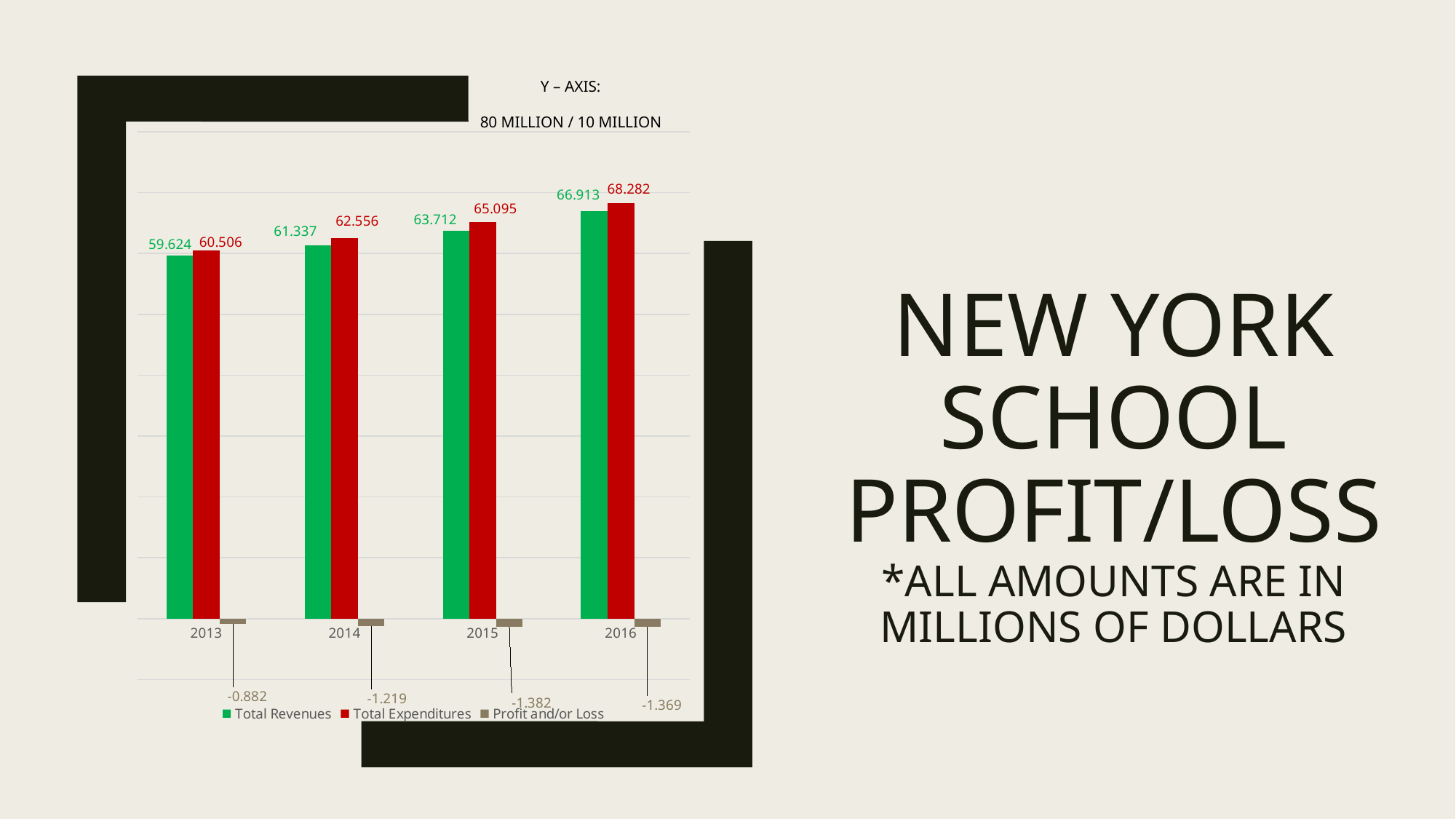
What kind of chart is shown on the slide? Bar chart Which is larger in 2015, Total Revenues or Total Expenditures? Total Expenditures Which year has the lowest Total Revenues? 2013 What is the Total Revenues value for 2014? 61.337 How many series does the chart legend list? 3 How many years are shown on the x axis of the chart? 4 Do Total Revenues rise or fall from 2013 to 2016? Rise What is the Profit and/or Loss value for 2015? -1.382 What is the Total Expenditures value for 2016? 68.282 What is the difference between Total Expenditures and Total Revenues in 2013? 0.882 Which year has the highest Total Expenditures? 2016 By how much did Total Revenues increase from 2013 to 2016? 7.289